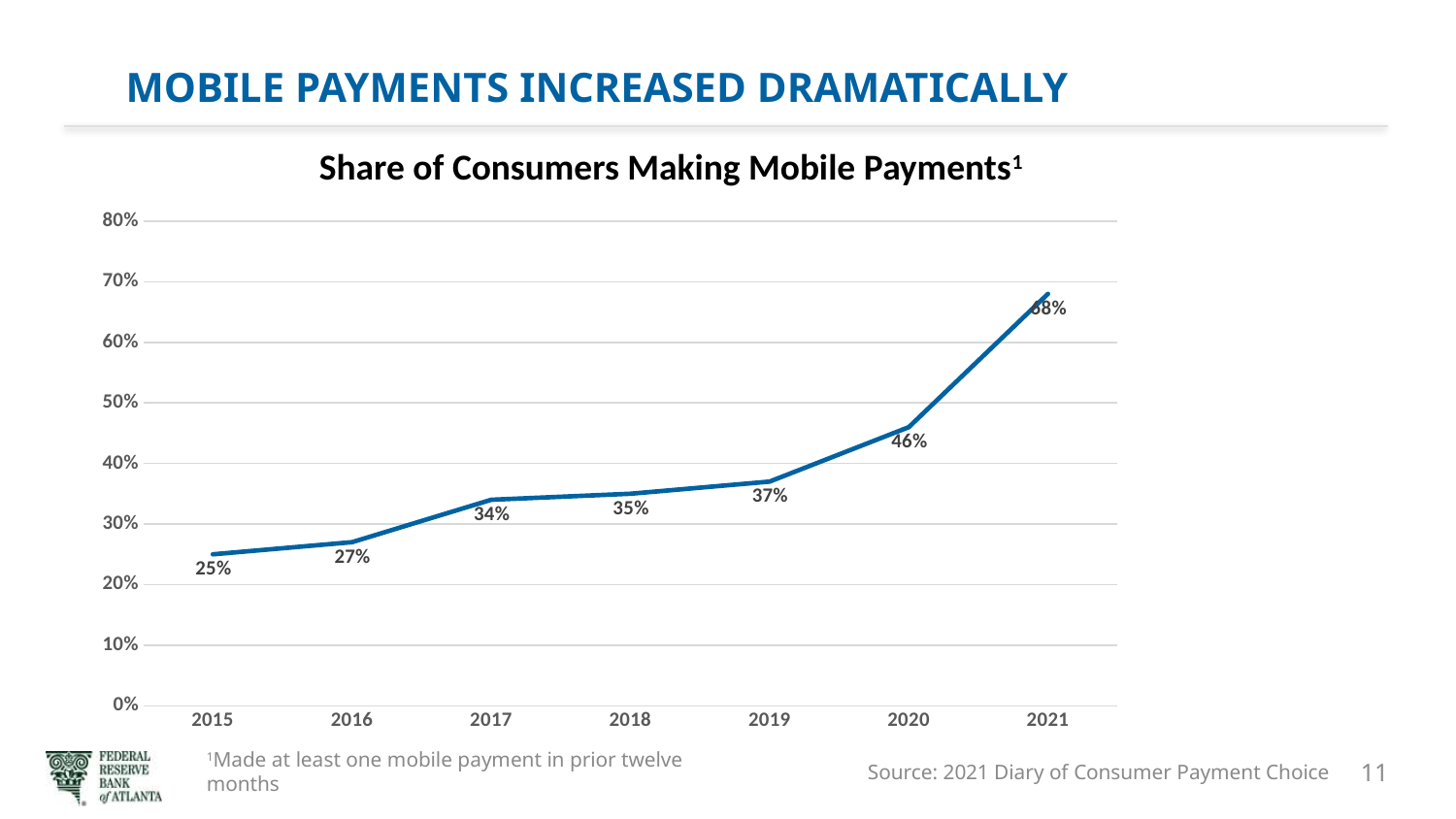
What is the difference between the values for 2020 and 2019? 9% Which year has the highest share of consumers making mobile payments? 2021 What is the value for 2020? 46% What is the title of the chart? Share of Consumers Making Mobile Payments What is the value for 2017? 34% What type of chart is shown on the slide? line chart How many years are plotted on the x axis? 7 What is the value for 2019? 37% Which year has the lowest share of consumers making mobile payments? 2015 Is the value for 2021 greater or less than 60%? greater What share of consumers made mobile payments in 2015? 25% Do the values rise or fall from 2015 to 2021? rise